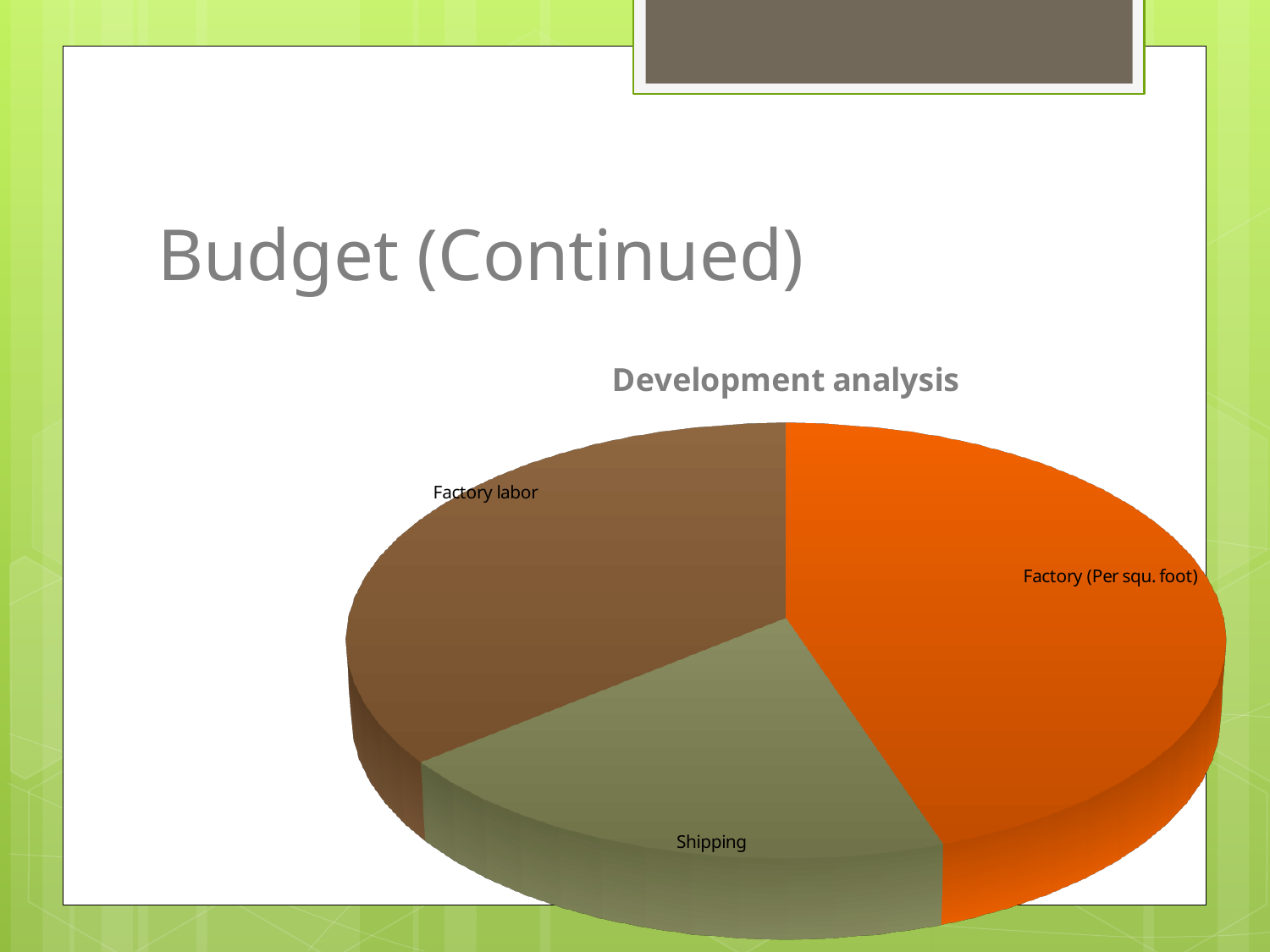
What kind of chart is shown on the slide? Pie chart Which slice is larger, Factory (Per squ. foot) or Shipping? Factory (Per squ. foot) What colour is the Shipping slice? Green What is the title of the chart? Development analysis How many slices does the pie chart have? 3 Which category has the largest slice of the pie? Factory (Per squ. foot) Which category is shown in orange? Factory (Per squ. foot)